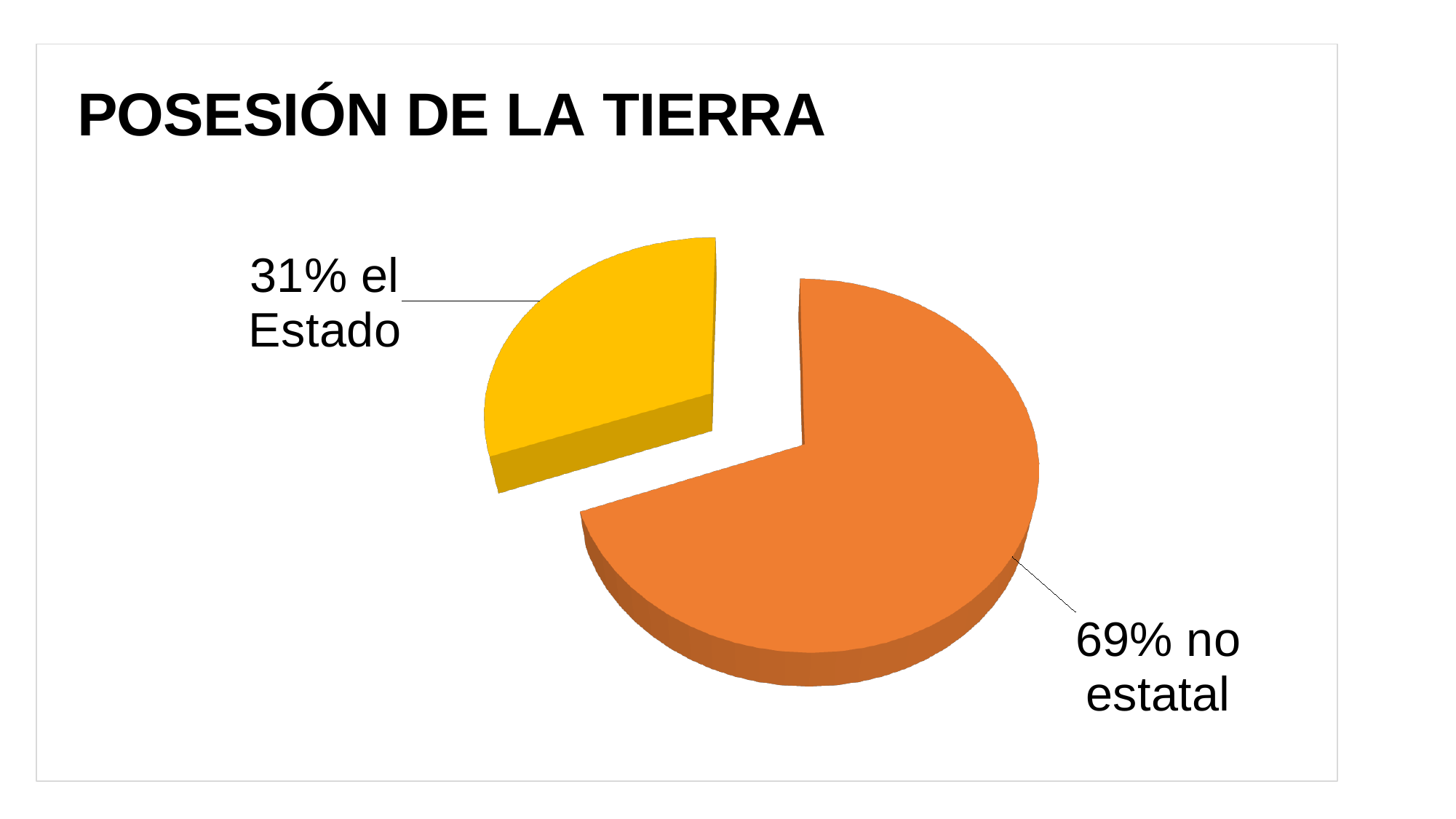
What share of the pie is labelled "no estatal"? 69% How many slices does the pie chart have? 2 What is the difference in percentage points between the "no estatal" and "el Estado" slices? 38 Which slice is the largest? no estatal Is the share for "el Estado" greater or less than 50%? less What colour is the "el Estado" slice? Yellow What share of the pie is labelled "el Estado"? 31% Which is larger, the "el Estado" slice or the "no estatal" slice? no estatal Which slice is the smallest? el Estado What kind of chart is shown on the slide? Pie chart What is the title of the chart? POSESIÓN DE LA TIERRA